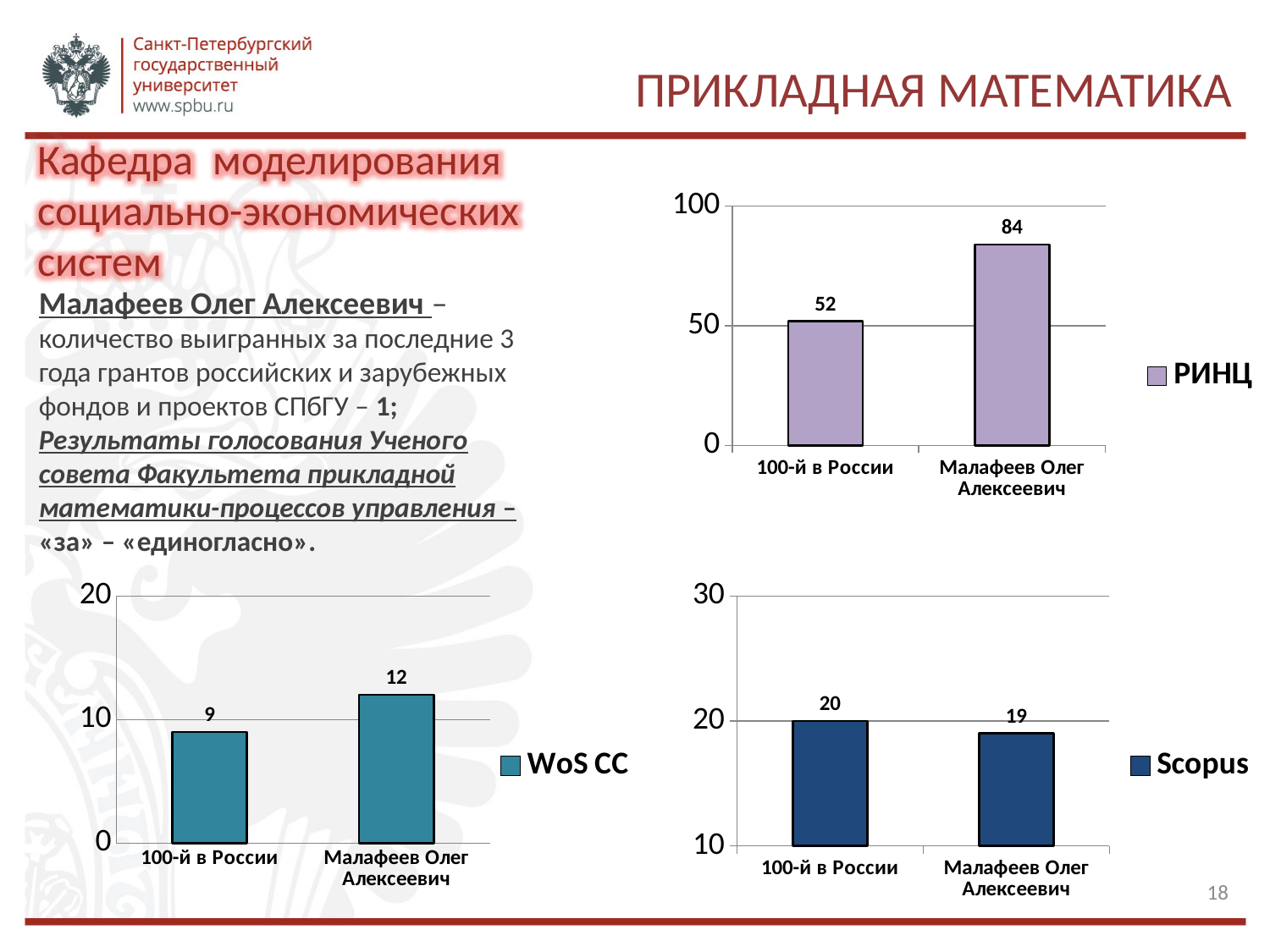
In the РИНЦ chart (top right), is the value for 100-й в России greater or less than 50? greater In the WoS CC chart (bottom left), which category has the highest value? Малафеев Олег Алексеевич What kind of chart is the WoS CC chart (bottom left)? bar chart In the Scopus chart (bottom right), which category has the lowest value? Малафеев Олег Алексеевич In the РИНЦ chart (top right), what is the value for Малафеев Олег Алексеевич? 84 In the WoS CC chart (bottom left), what is the value for 100-й в России? 9 In the Scopus chart (bottom right), what is the difference between the values for 100-й в России and Малафеев Олег Алексеевич? 1 In the РИНЦ chart (top right), what is the value for 100-й в России? 52 In the WoS CC chart (bottom left), what is the difference between the values for Малафеев Олег Алексеевич and 100-й в России? 3 In the РИНЦ chart (top right), what is the difference between the values for Малафеев Олег Алексеевич and 100-й в России? 32 How many categories are shown in the Scopus chart (bottom right)? 2 In the Scopus chart (bottom right), what is the value for Малафеев Олег Алексеевич? 19